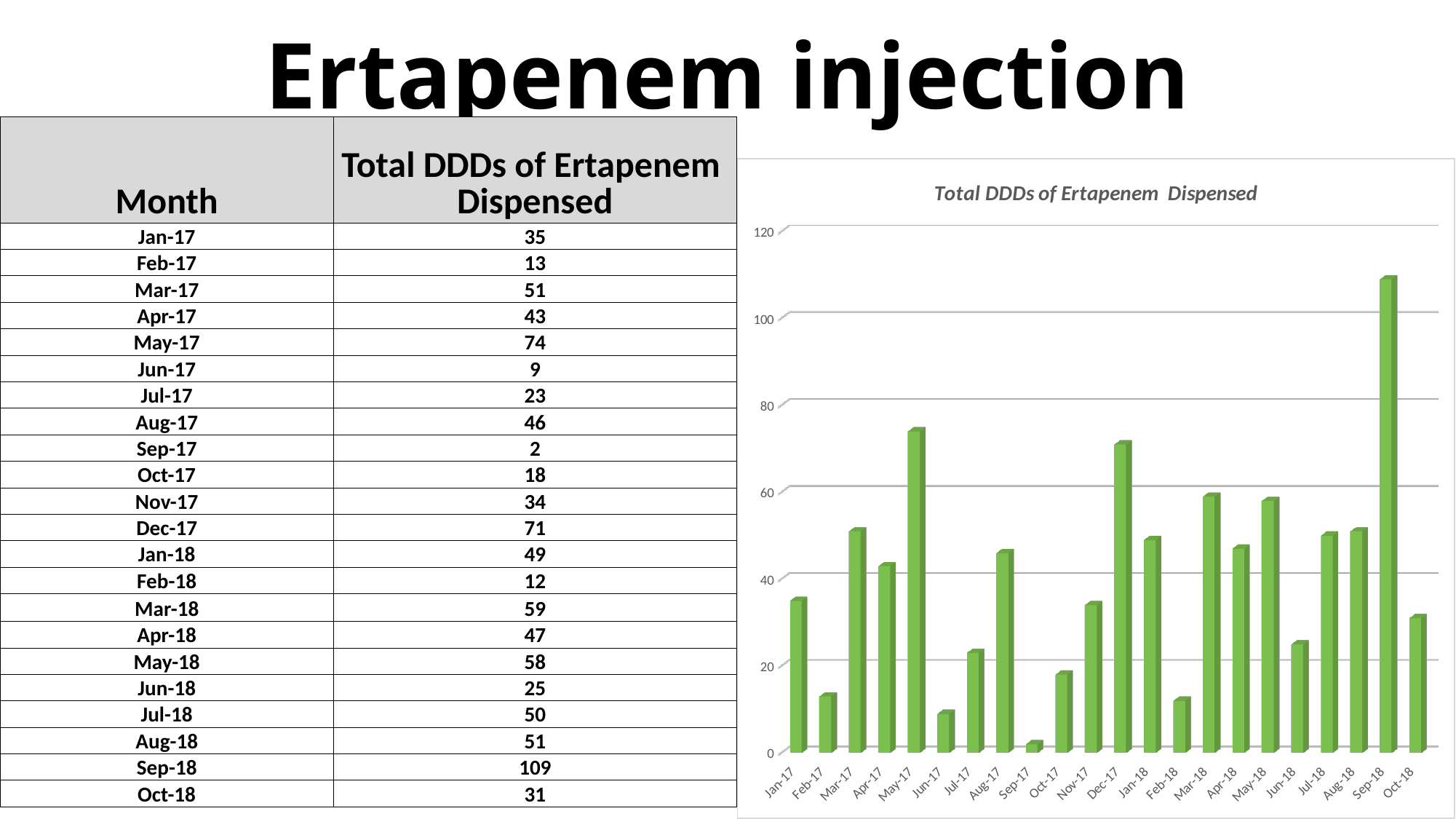
Which month has the highest total DDDs of Ertapenem dispensed? Sep-18 How many months are plotted on the chart? 22 What is the title of the chart? Total DDDs of Ertapenem Dispensed Which is larger, the value for Mar-18 or the value for Apr-18? Mar-18 What is the value for Sep-18? 109 Is the value for Sep-18 greater or less than 100? greater Which month has the lowest total DDDs of Ertapenem dispensed? Sep-17 What is the difference between the values for Sep-18 and Oct-18? 78 What type of chart is shown on the slide? bar chart What is the value for Dec-17? 71 What is the value for May-17? 74 Is the value for Jun-17 greater or less than 20? less